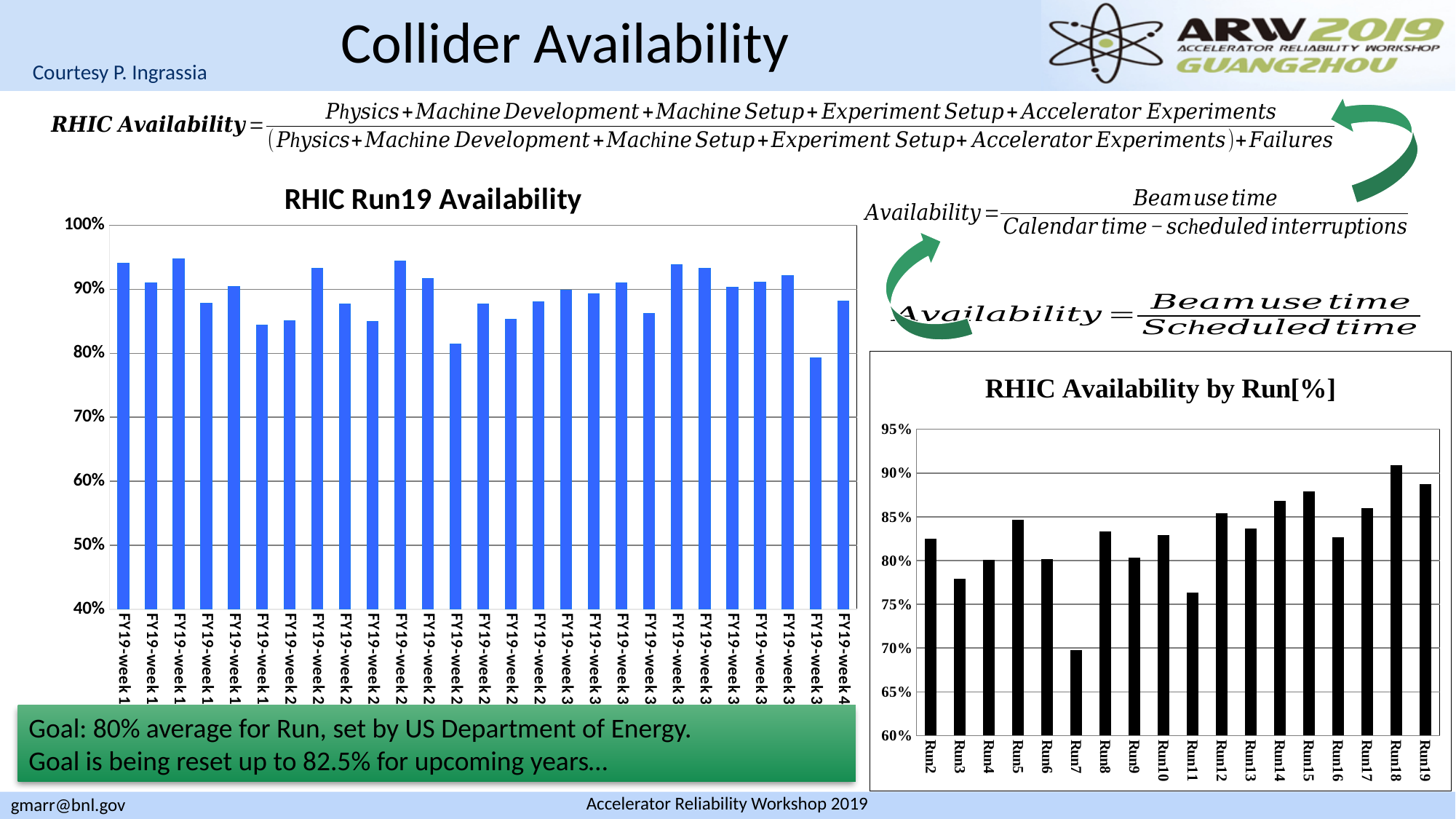
In the 'RHIC Availability by Run[%]' chart, which is larger, Run15 or Run16? Run15 In the 'RHIC Availability by Run[%]' chart, is the value for Run7 greater or less than 75%? less What type of chart is the 'RHIC Run19 Availability' chart? bar chart In the 'RHIC Availability by Run[%]' chart, which run has the highest availability? Run18 In the 'RHIC Availability by Run[%]' chart, is the value for Run19 greater or less than 85%? greater In the 'RHIC Availability by Run[%]' chart, is the value for Run3 greater or less than 80%? less What type of chart is the 'RHIC Availability by Run[%]' chart? bar chart In the 'RHIC Availability by Run[%]' chart, which run has the lowest availability? Run7 In the 'RHIC Availability by Run[%]' chart, which is larger, Run12 or Run3? Run12 In the 'RHIC Availability by Run[%]' chart, how many runs are plotted? 18